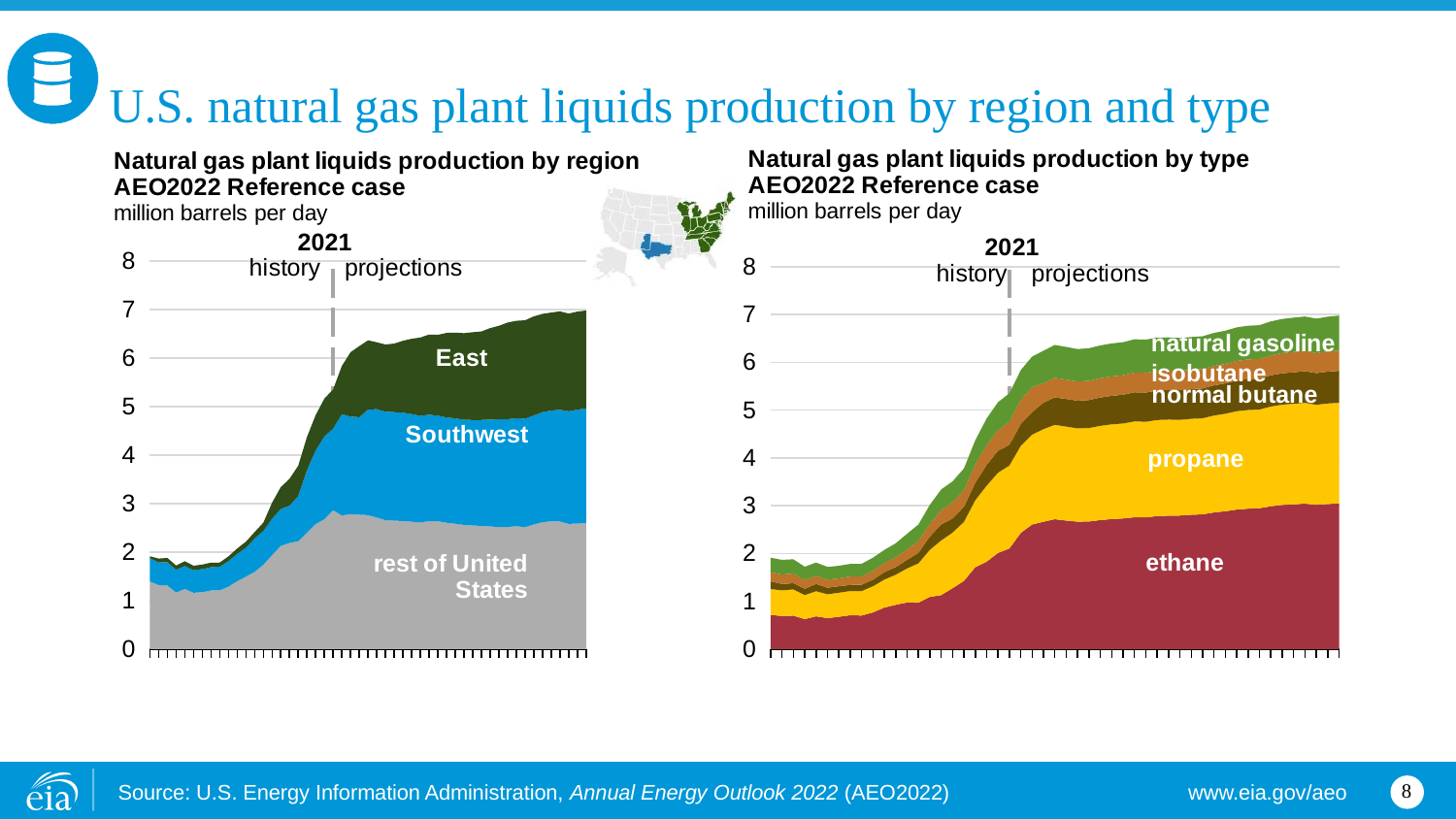
In the right chart by type, at the end of the projection period, which is larger: ethane or propane? ethane In the right chart by type, which type contributes the smallest share of production at the end of the projection period? isobutane In the left chart by region, is total production at the end of the projection period greater or less than 6 million barrels per day? greater In the left chart by region, does total natural gas plant liquids production rise or fall from the start of the history period to the end of the projections? rise In the right chart by type, is ethane production at the end of the projection period greater or less than 2 million barrels per day? greater How many liquid types are shown in the right chart, 'Natural gas plant liquids production by type'? 5 In the right chart by type, is total production at the end of the projection period greater or less than 6 million barrels per day? greater What year marks the boundary between history and projections on both charts? 2021 How many regions are shown in the left chart, 'Natural gas plant liquids production by region'? 3 What unit of measurement is used on both charts? million barrels per day In the left chart by region, which region contributes the largest share of production at the end of the projection period? rest of United States What kind of chart is the 'Natural gas plant liquids production by region' chart on the left? stacked area chart